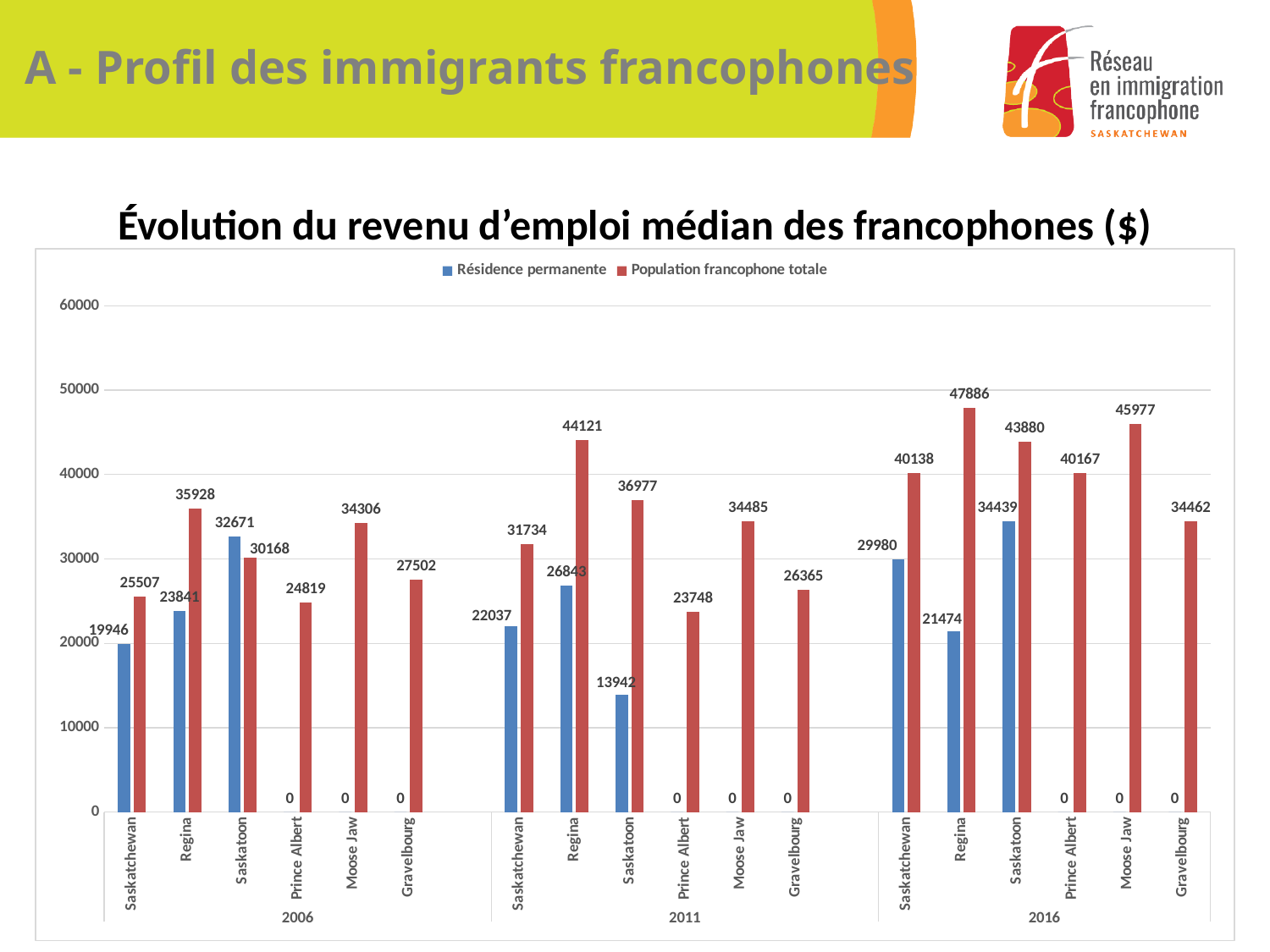
What colour represents the Résidence permanente series? Blue In 2006, which is larger for Saskatoon: Résidence permanente or Population francophone totale? Résidence permanente How does the Population francophone totale value for Saskatchewan change from 2006 to 2016? It rises How many series does the legend list? 2 What is the value of Population francophone totale for Gravelbourg in 2006? 27502 Which category has the lowest non-zero Résidence permanente value? Saskatoon (2011) How many year groups are shown on the x axis? 3 What is the value of Résidence permanente for Saskatoon in 2011? 13942 What is the difference between Population francophone totale and Résidence permanente for Saskatchewan in 2016? 10158 What type of chart is shown on the slide? bar chart What is the value of Population francophone totale for Regina in 2016? 47886 Which category has the highest Population francophone totale value across the whole chart? Regina (2016)